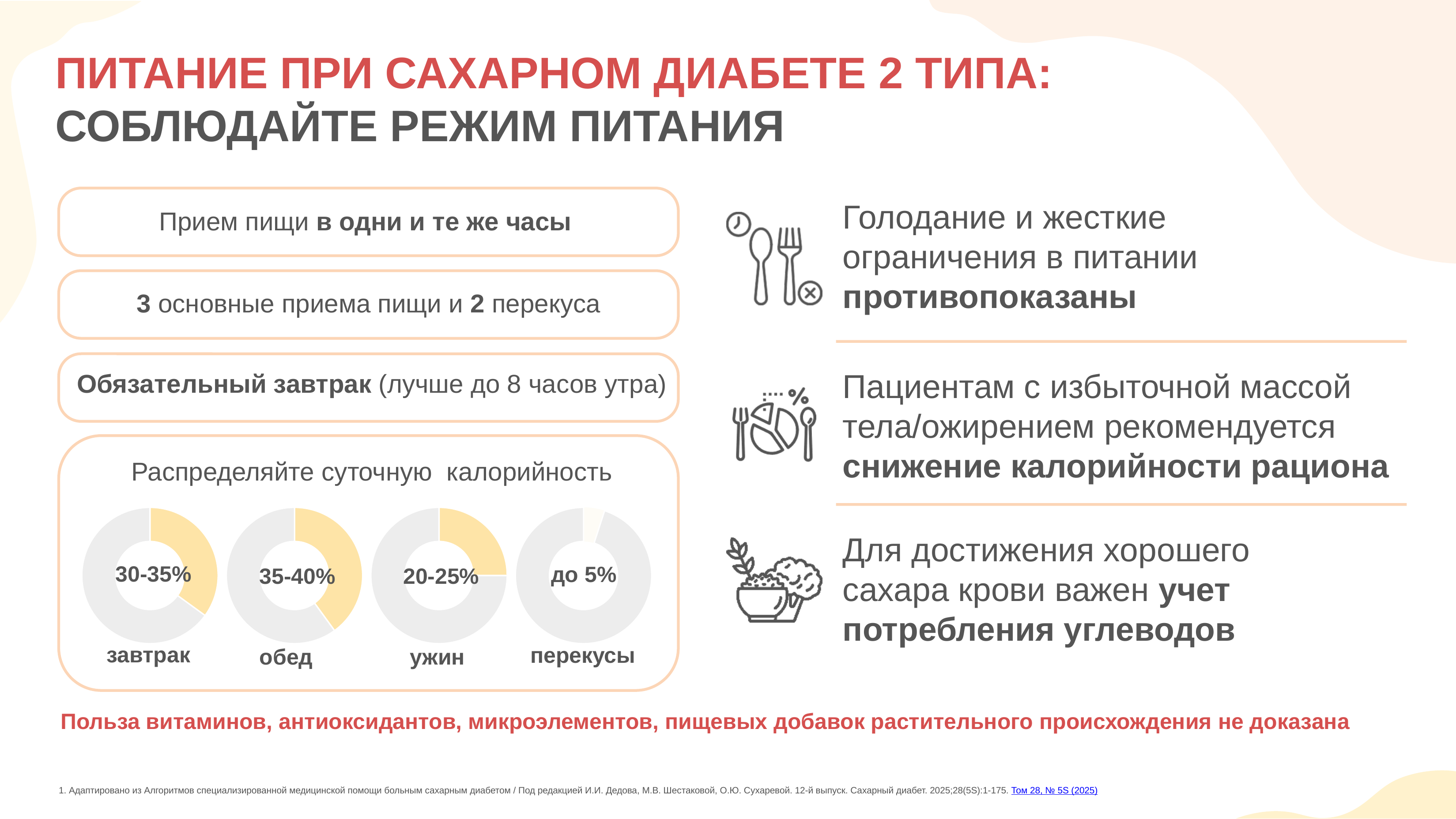
What kind of chart is used to show the calorie share for each meal in the 'Распределяйте суточную калорийность' section? donut chart In the 'Распределяйте суточную калорийность' section, what share of daily calories is shown for обед? 35-40% In the 'Распределяйте суточную калорийность' section, what share of daily calories is shown for ужин? 20-25% In the 'Распределяйте суточную калорийность' section, which has a larger share of daily calories, ужин or перекусы? ужин What is the title of the section containing the four donut charts? Распределяйте суточную калорийность In the 'Распределяйте суточную калорийность' section, which meal has the largest share of daily calories? обед In the 'Распределяйте суточную калорийность' section, what share of daily calories is shown for завтрак? 30-35% In the 'Распределяйте суточную калорийность' section, what share of daily calories is shown for перекусы? до 5% In the 'Распределяйте суточную калорийность' section, which has a larger share of daily calories, завтрак or ужин? завтрак What colour is the highlighted segment in the donut charts in the 'Распределяйте суточную калорийность' section? yellow In the 'Распределяйте суточную калорийность' section, which meal has the smallest share of daily calories? перекусы How many donut charts are shown in the 'Распределяйте суточную калорийность' section? 4